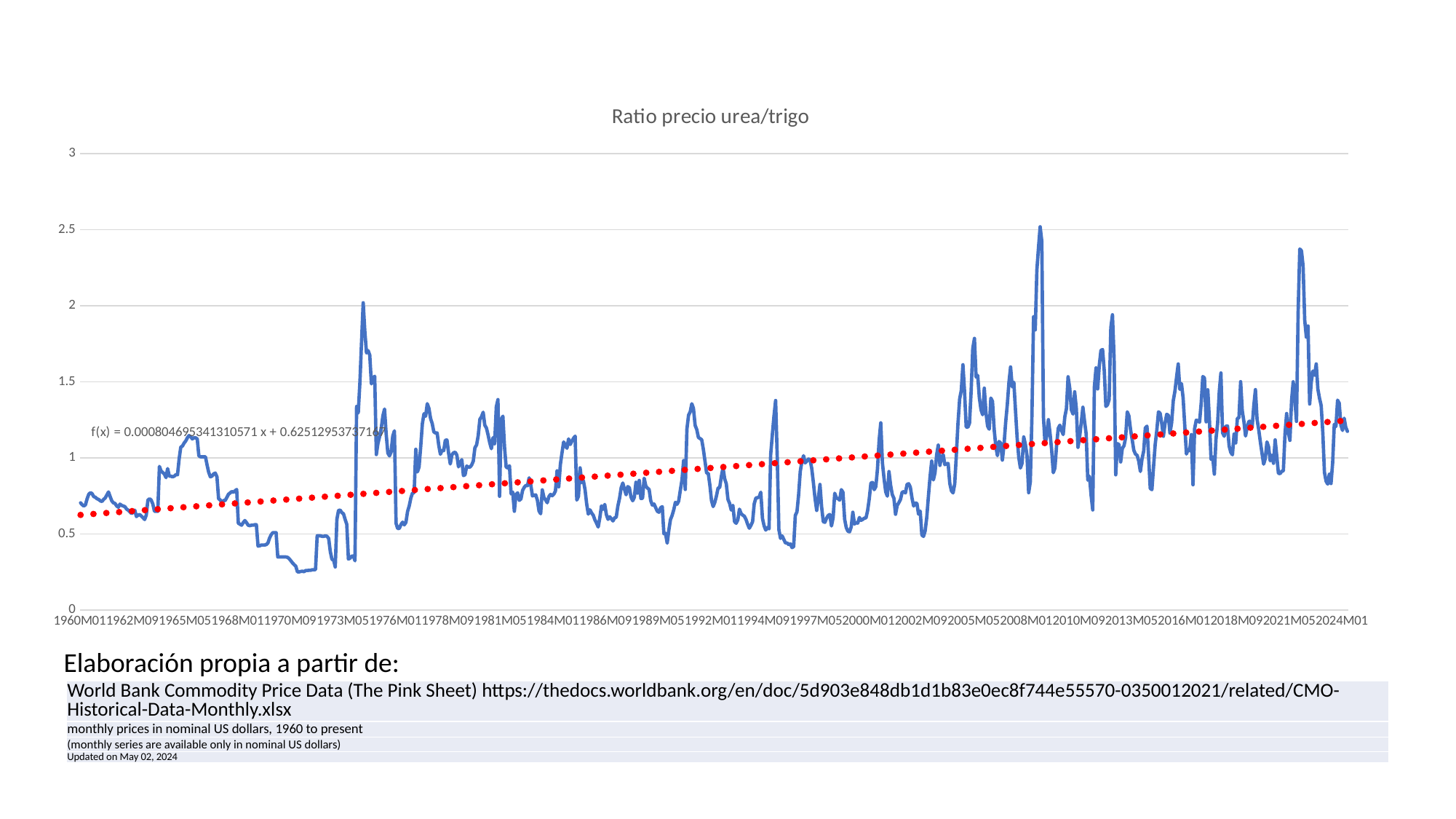
Is the highest peak of the blue line, near 2008M01, greater or less than 2? greater Is the value of the blue line at 1960M01 greater or less than 1? less Is the value of the red trendline at 2024M01 greater or less than 1? greater What is the highest value shown on the vertical axis? 3 Which period has the higher peak in the blue line: around 1976M01 or around 2008M01? around 2008M01 What kind of chart is shown on the slide? line chart Does the red dotted trendline rise or fall from left to right? rise Is the value of the blue line around 1970M09 greater or less than the value around 2008M01? less What is the title of the chart? Ratio precio urea/trigo